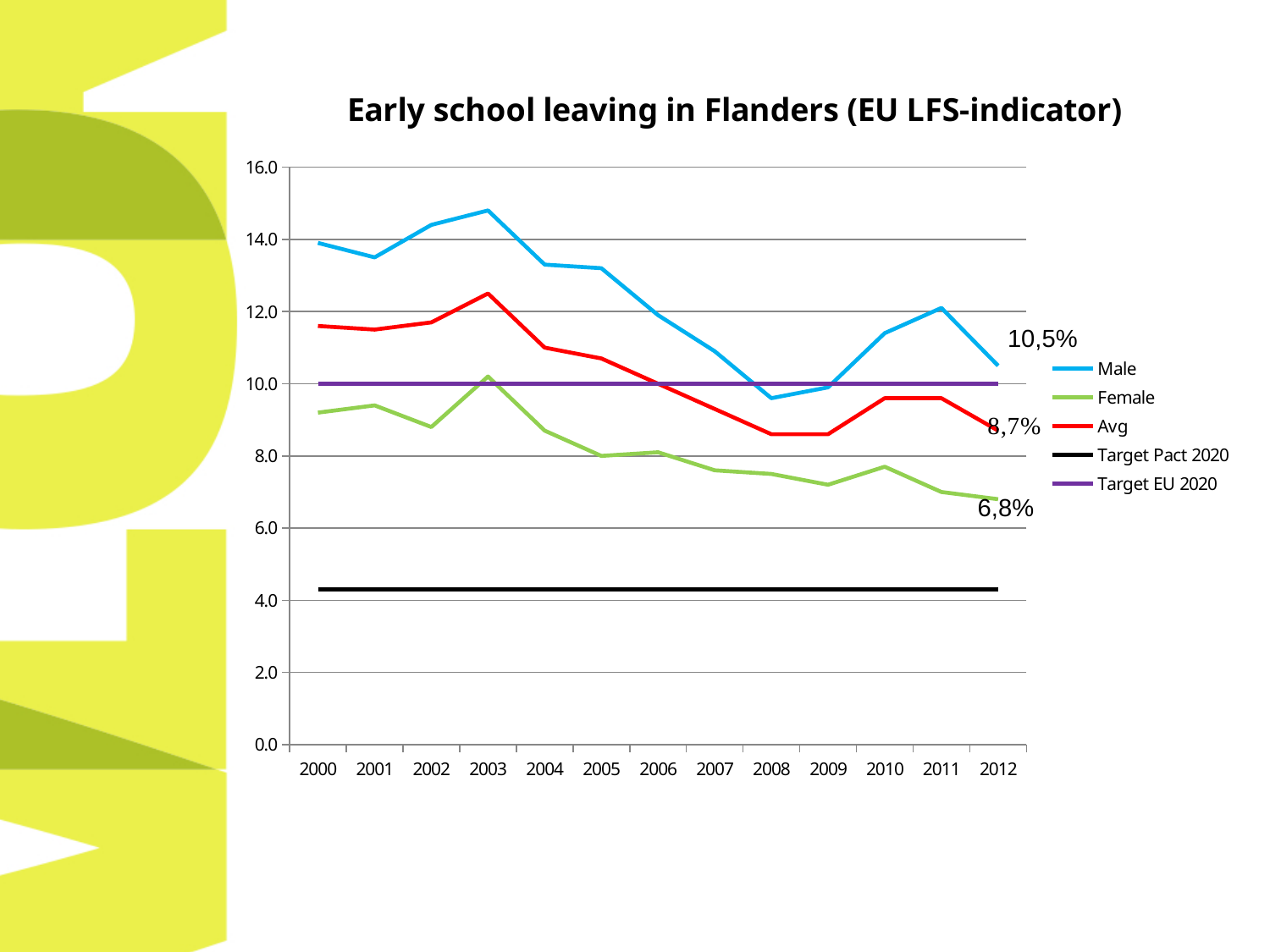
Which series has the highest value in 2012? Male What is the Female value in 2012? 6,8% Is the Male value for 2003 greater or less than 14.0? greater Does the Female line rise or fall overall from 2000 to 2012? fall How many years are shown on the x axis? 13 What kind of chart is shown on the slide? line chart What is the Avg value in 2012? 8,7% What is the title of the chart? Early school leaving in Flanders (EU LFS-indicator) What is the Male value in 2012? 10,5% What is the difference between the Male and Female values in 2012? 3,7% How many series does the legend list? 5 Is the Female value for 2005 greater or less than 10.0? less